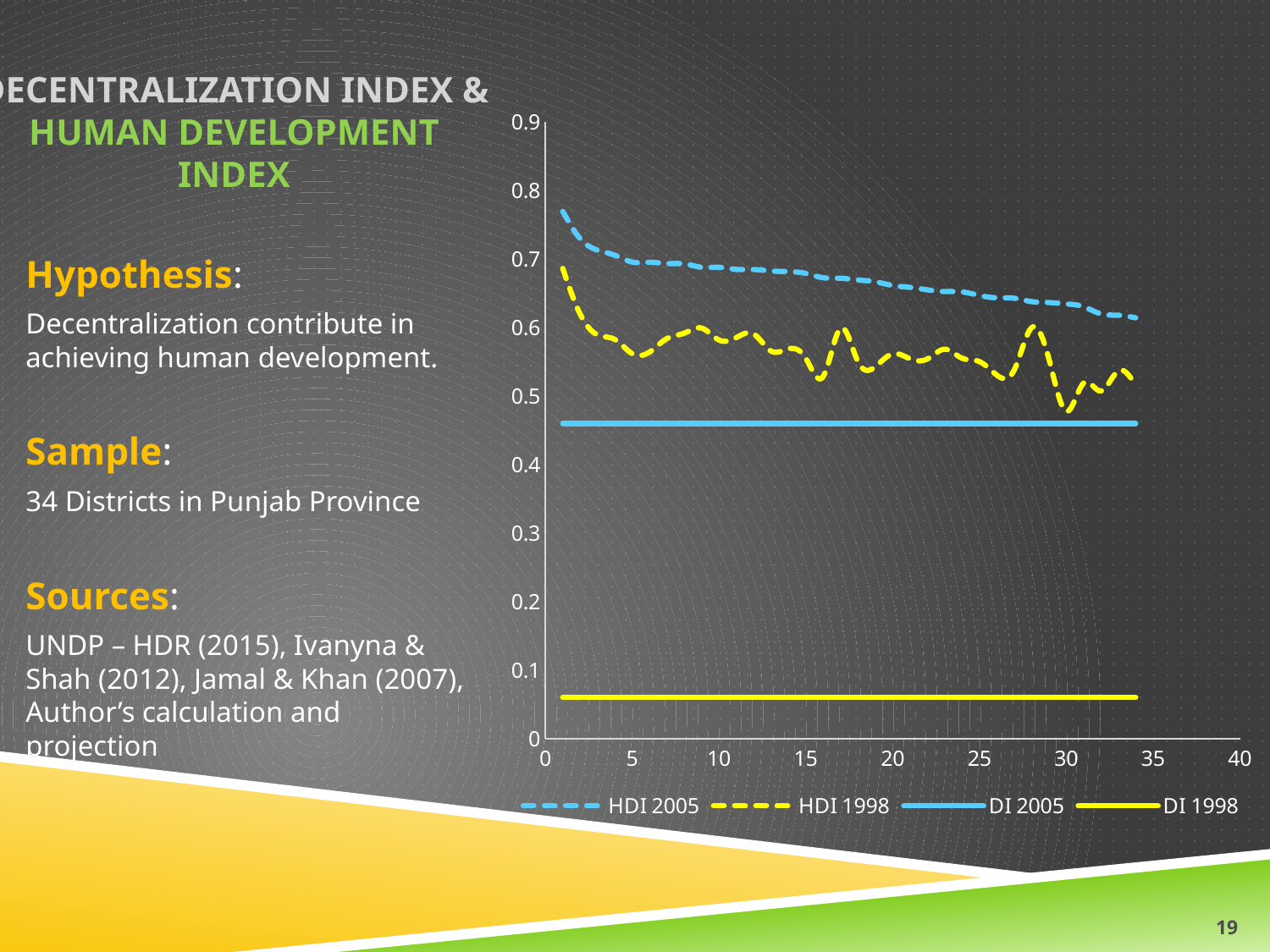
Which series has higher values, HDI 2005 or HDI 1998? HDI 2005 Is the HDI 1998 value at x = 5 greater or less than 0.5? greater What kind of chart is shown on the slide? line chart How many series does the chart legend list? 4 Is the HDI 2005 value at x = 5 greater or less than 0.6? greater Does the HDI 2005 line rise or fall as the x axis increases? fall What colour is the DI 1998 line in the chart? yellow Which series has the lowest values on the chart? DI 1998 Is the value of the DI 2005 line greater or less than 0.5? less Which series has higher values, DI 2005 or DI 1998? DI 2005 Which series are listed in the chart legend? HDI 2005, HDI 1998, DI 2005, DI 1998